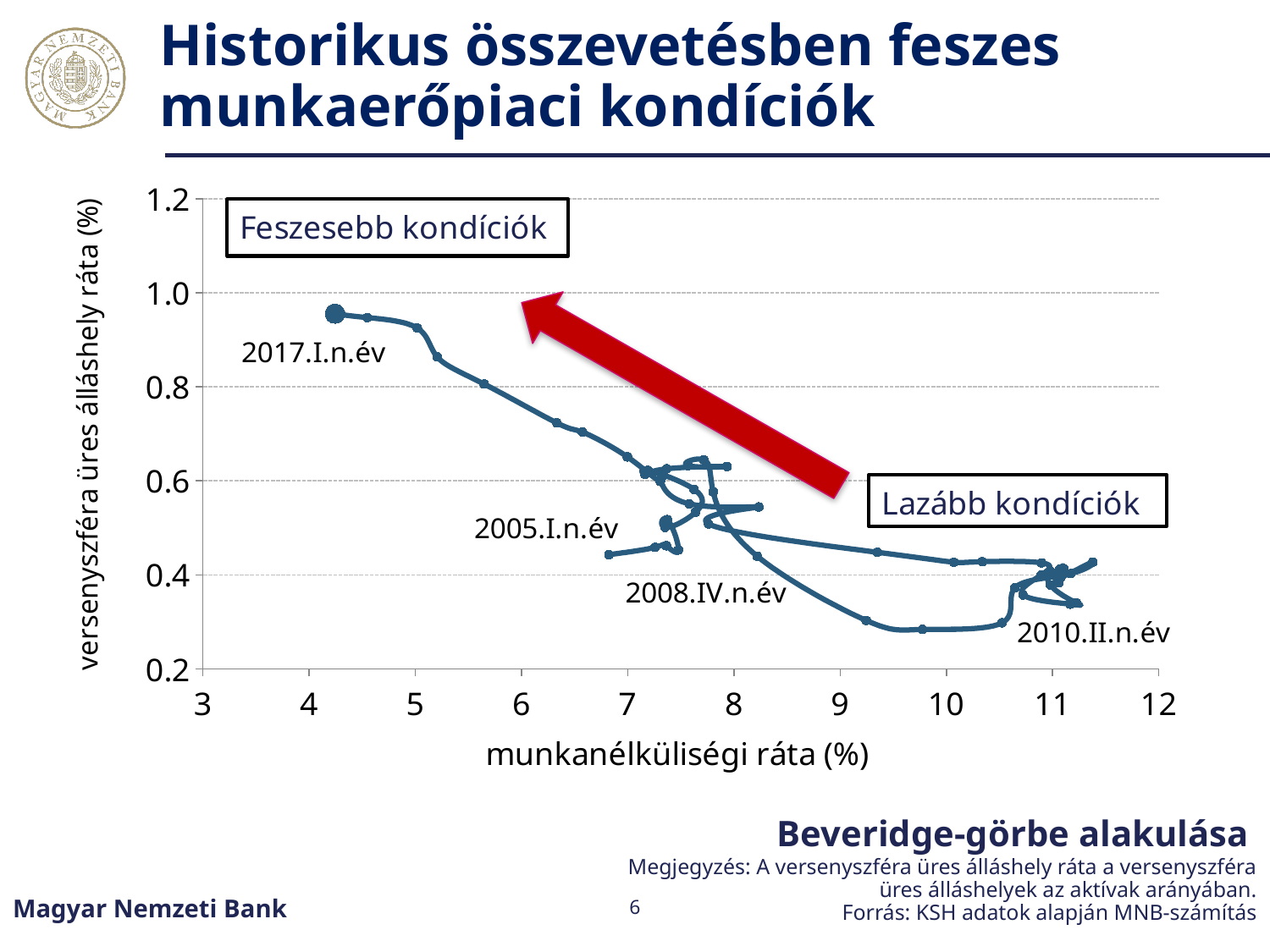
What is the label of the horizontal axis? munkanélküliségi ráta (%) Is the unemployment rate (x value) for the point labelled 2010.II.n.év greater or less than 10? greater Is the vacancy rate (y value) for the point labelled 2005.I.n.év greater or less than 0.6? less Which labelled point has the higher unemployment rate, 2005.I.n.év or 2010.II.n.év? 2010.II.n.év What kind of chart is shown on the slide? scatter chart Is the vacancy rate (y value) for the point labelled 2010.II.n.év greater or less than 0.4? less What is the title of the chart? Beveridge-görbe alakulása Among the labelled points, which has the lowest unemployment rate? 2017.I.n.év Which labelled point has the higher vacancy rate, 2017.I.n.év or 2010.II.n.év? 2017.I.n.év